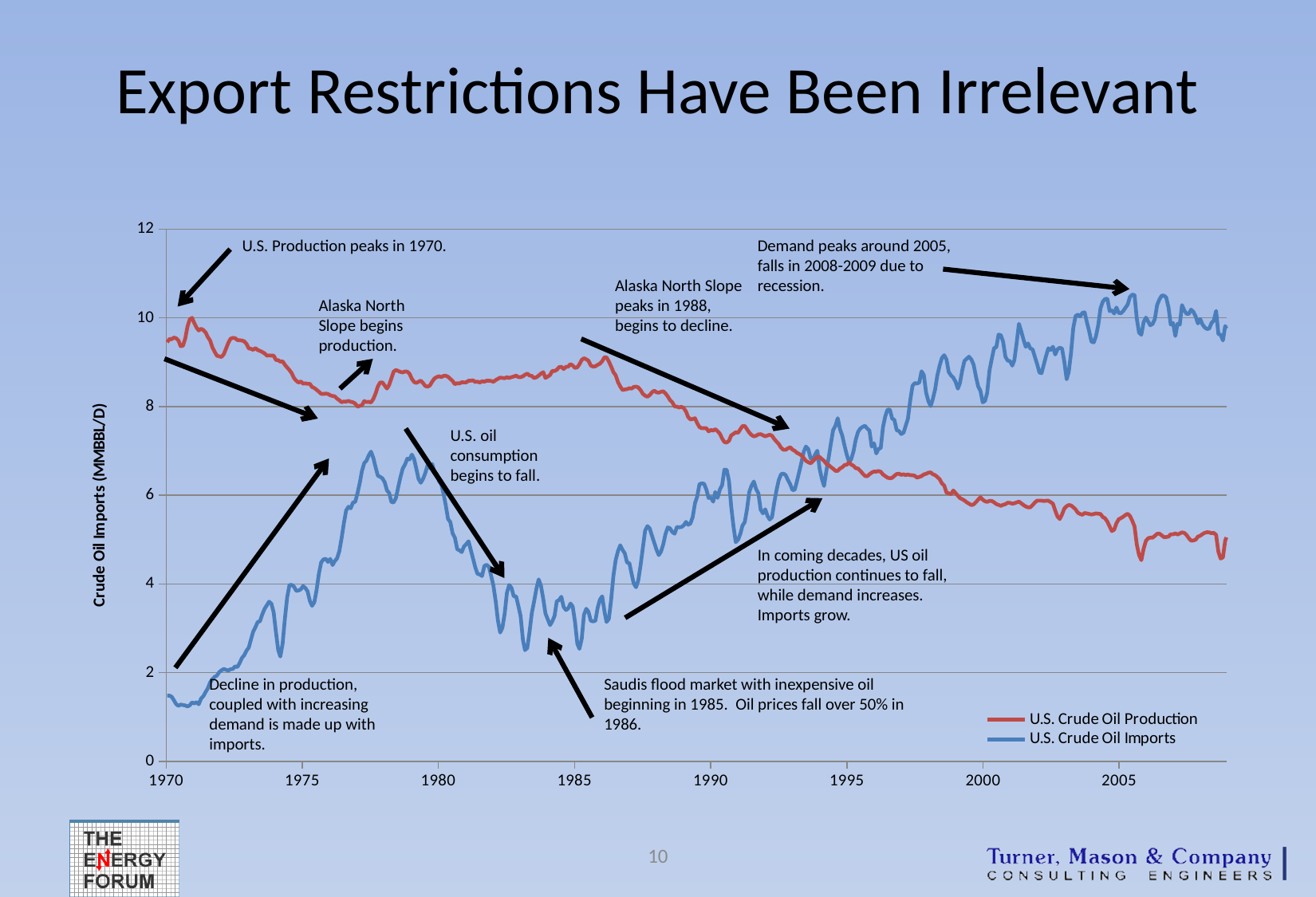
Does U.S. Crude Oil Production rise or fall overall from 1970 to the end of the chart? Fall Is the value for U.S. Crude Oil Imports in 2005 greater or less than 8? greater Is the value for U.S. Crude Oil Production in 2005 greater or less than 6? less How many series does the legend list? 2 Does U.S. Crude Oil Imports rise or fall overall from 1970 to the end of the chart? Rise In 2005, which series has the larger value, U.S. Crude Oil Production or U.S. Crude Oil Imports? U.S. Crude Oil Imports What are the two series named in the legend? U.S. Crude Oil Production and U.S. Crude Oil Imports In 1970, which series has the larger value, U.S. Crude Oil Production or U.S. Crude Oil Imports? U.S. Crude Oil Production What is the label on the vertical axis? Crude Oil Imports (MMBBL/D) Is the value for U.S. Crude Oil Production in 1970 greater or less than 8? greater What kind of chart is shown on the slide? Line chart